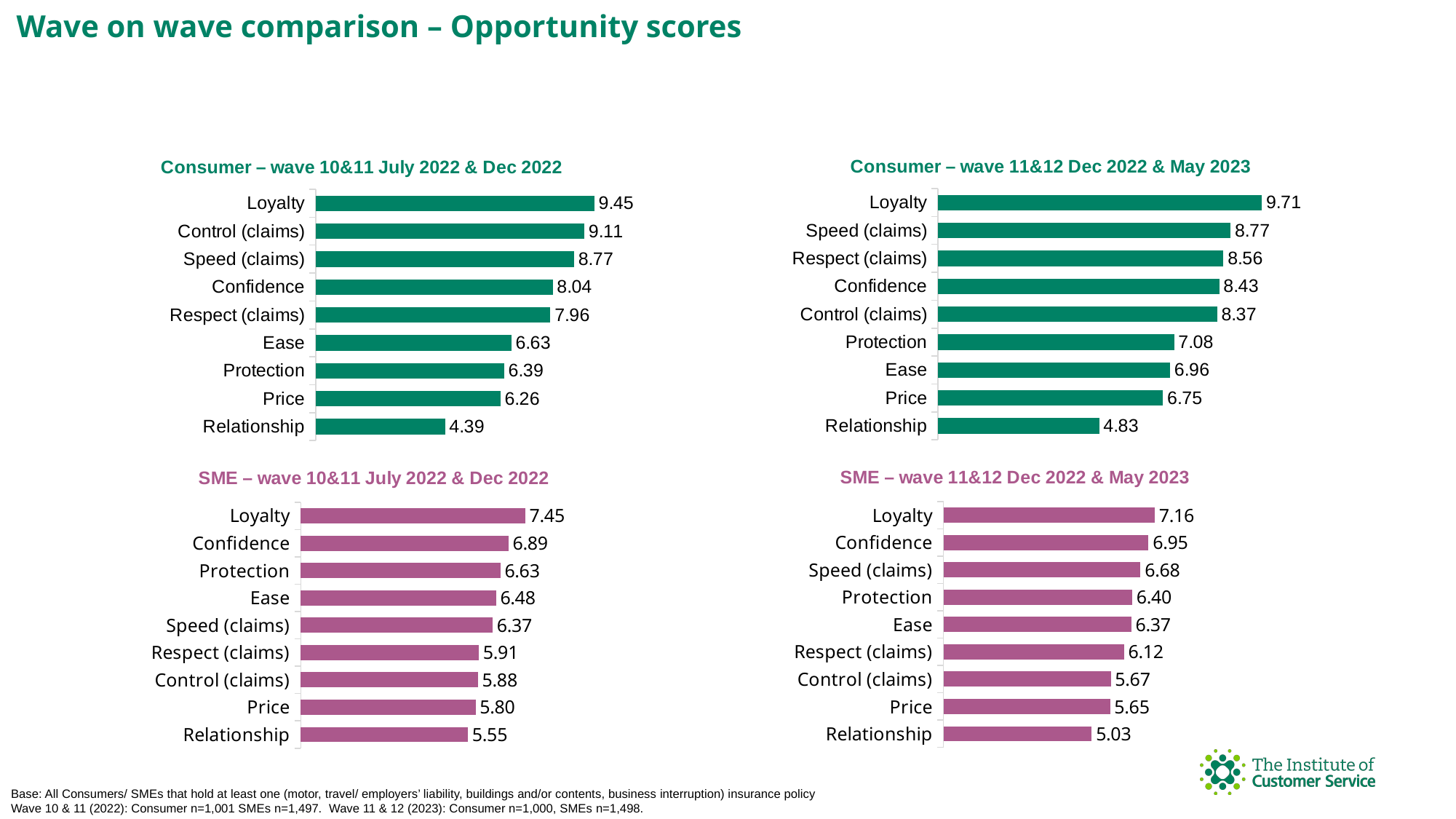
In the 'SME – wave 11&12 Dec 2022 & May 2023' chart, what is the value for Respect (claims)? 6.12 In the 'Consumer – wave 10&11 July 2022 & Dec 2022' chart, what is the difference between Loyalty and Relationship? 5.06 In the 'Consumer – wave 11&12 Dec 2022 & May 2023' chart, which is larger, Speed (claims) or Control (claims)? Speed (claims) In the 'Consumer – wave 11&12 Dec 2022 & May 2023' chart, which category has the highest value? Loyalty What kind of chart is the 'Consumer – wave 10&11 July 2022 & Dec 2022' chart? Bar chart How many charts are shown on the slide? 4 How many categories are shown in the 'SME – wave 10&11 July 2022 & Dec 2022' chart? 9 In the 'Consumer – wave 10&11 July 2022 & Dec 2022' chart, what is the value for Control (claims)? 9.11 In the 'SME – wave 10&11 July 2022 & Dec 2022' chart, what is the value for Ease? 6.48 In the 'SME – wave 11&12 Dec 2022 & May 2023' chart, what is the difference between Loyalty and Confidence? 0.21 In the 'Consumer – wave 11&12 Dec 2022 & May 2023' chart, what is the value for Protection? 7.08 In the 'SME – wave 10&11 July 2022 & Dec 2022' chart, which category has the lowest value? Relationship